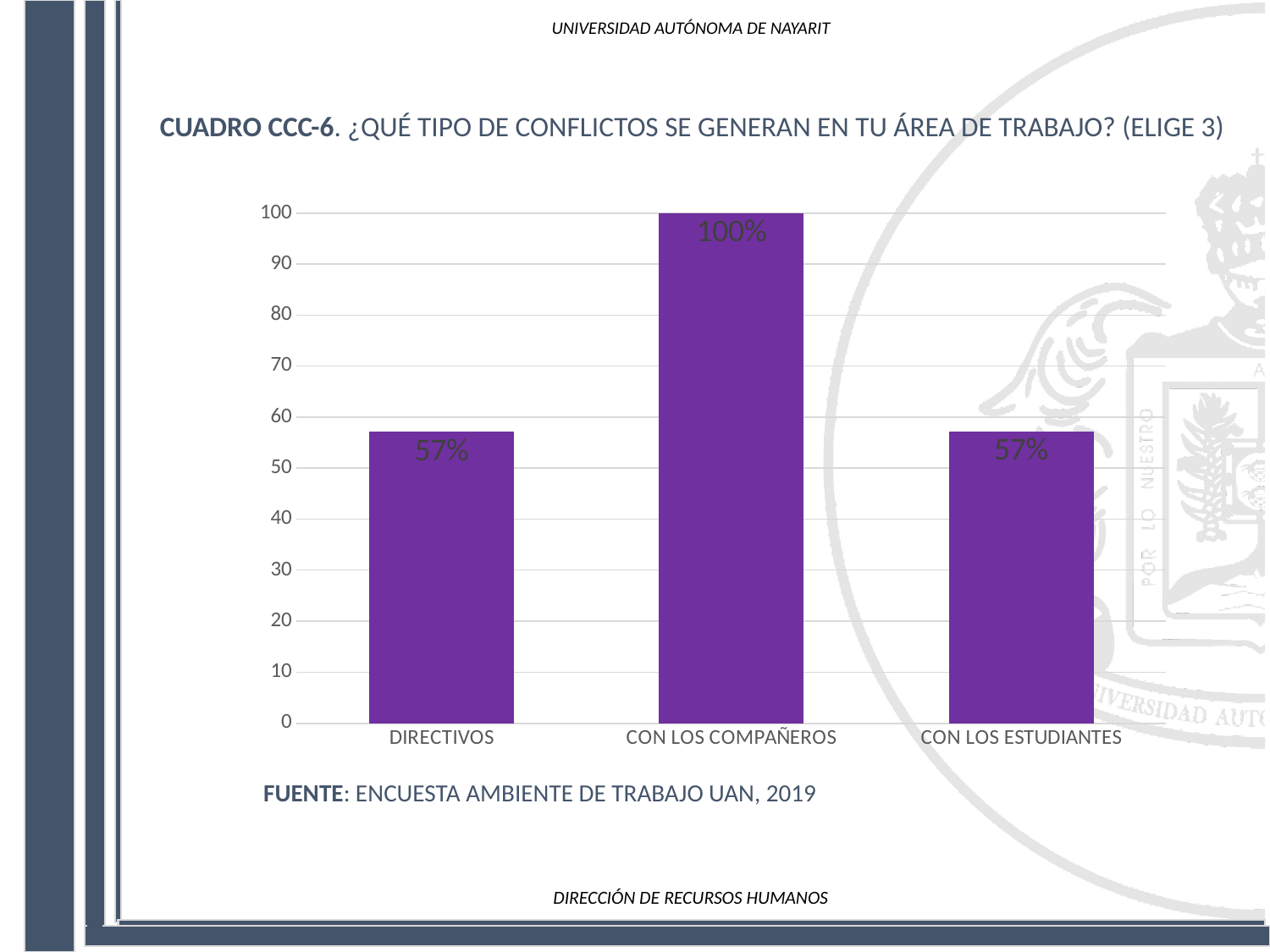
Is the value for CON LOS COMPAÑEROS greater or less than 90? greater Which is larger, the value for CON LOS COMPAÑEROS or the value for CON LOS ESTUDIANTES? CON LOS COMPAÑEROS Is the value for DIRECTIVOS greater or less than 60? less What is the maximum value shown on the y axis? 100 What is the value for CON LOS COMPAÑEROS? 100% What kind of chart is shown on the slide? bar chart What is the difference between the values for CON LOS COMPAÑEROS and DIRECTIVOS? 43% How many categories are shown on the x axis? 3 What is the value for DIRECTIVOS? 57% Which category has the highest value? CON LOS COMPAÑEROS What is the source cited below the chart? ENCUESTA AMBIENTE DE TRABAJO UAN, 2019 What is the value for CON LOS ESTUDIANTES? 57%